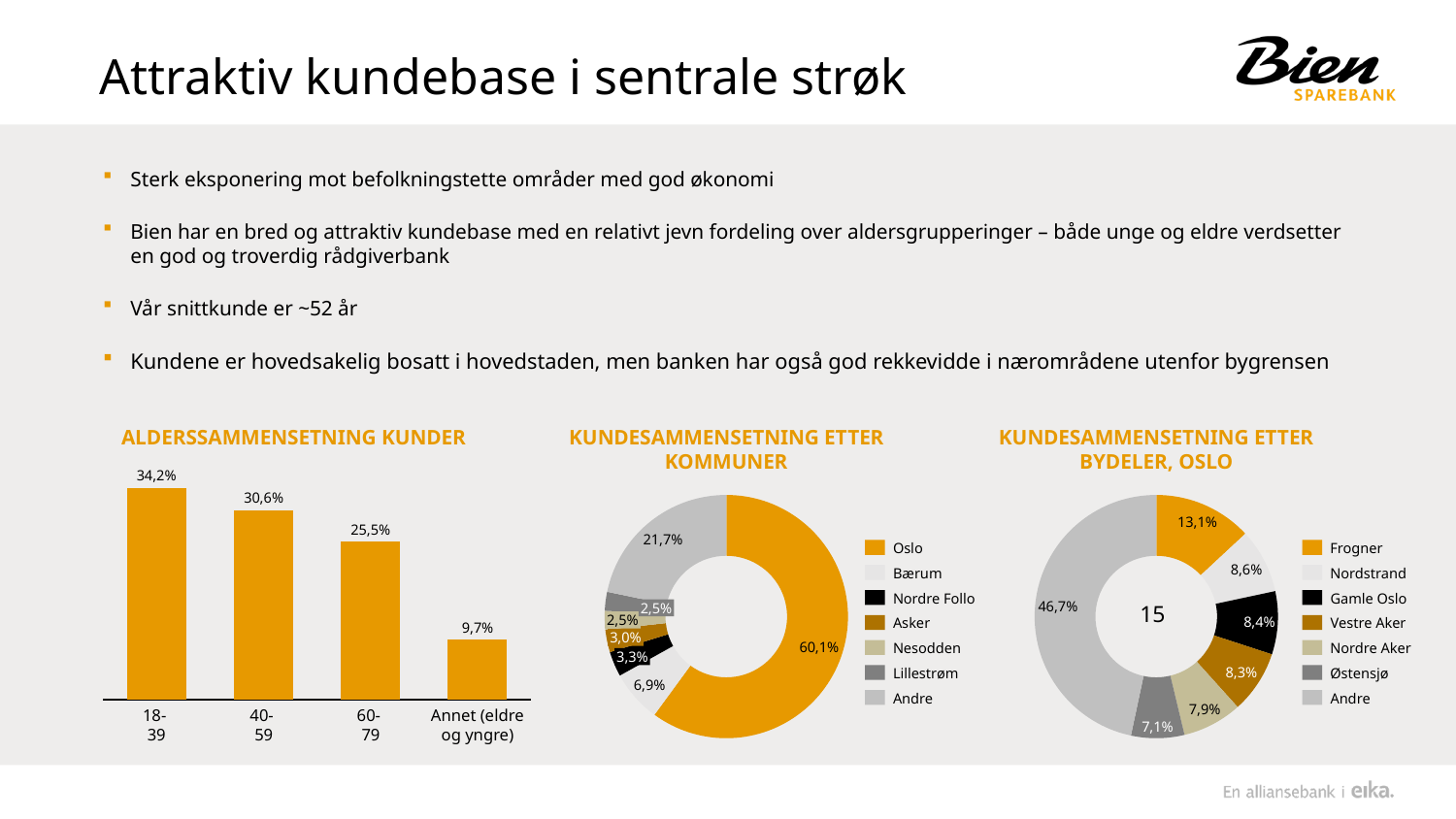
In the 'KUNDESAMMENSETNING ETTER BYDELER, OSLO' chart, which slice is the largest? Andre In the 'ALDERSSAMMENSETNING KUNDER' chart, do the values rise or fall from 18-39 to Annet (eldre og yngre)? Fall In the 'KUNDESAMMENSETNING ETTER KOMMUNER' chart, what share of customers is in Oslo? 60,1% In the 'ALDERSSAMMENSETNING KUNDER' chart, what is the value for the 18-39 age group? 34,2% In the 'KUNDESAMMENSETNING ETTER BYDELER, OSLO' chart, which is larger, Nordstrand or Gamle Oslo? Nordstrand How many entries does the legend of the 'KUNDESAMMENSETNING ETTER KOMMUNER' chart list? 7 In the 'KUNDESAMMENSETNING ETTER BYDELER, OSLO' chart, what is the value for Frogner? 13,1% In the 'ALDERSSAMMENSETNING KUNDER' chart, what is the difference between the 18-39 and 40-59 groups? 3,6% In the 'ALDERSSAMMENSETNING KUNDER' chart, which category has the lowest value? Annet (eldre og yngre) What kind of chart is 'ALDERSSAMMENSETNING KUNDER'? Bar chart How many categories are shown in the 'ALDERSSAMMENSETNING KUNDER' chart? 4 In the 'ALDERSSAMMENSETNING KUNDER' chart, which age group has the highest value? 18-39